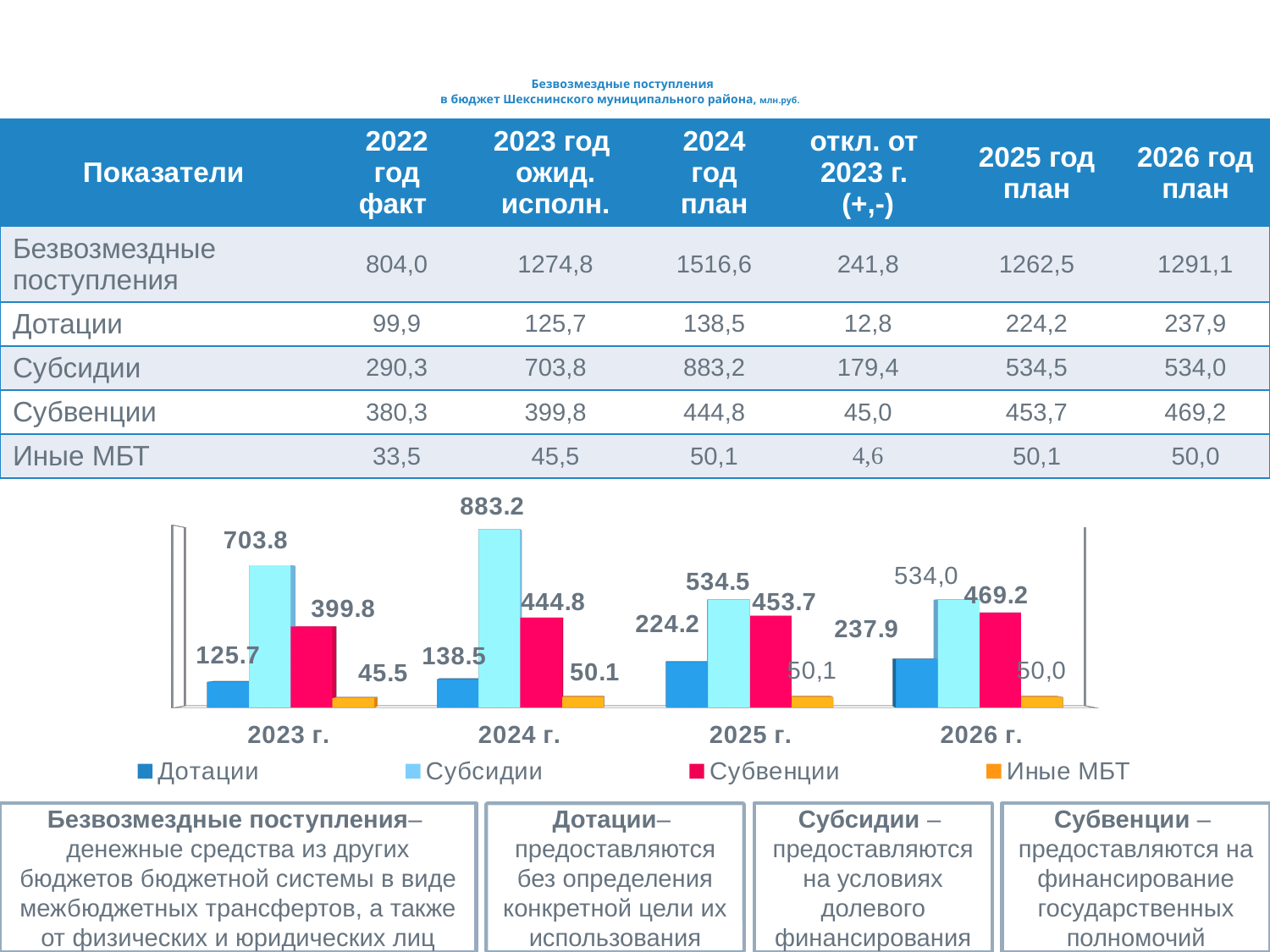
What is the difference between Субсидии and Субвенции in 2023 г. in the chart? 304.0 How many series does the chart legend list? 4 Which is larger in 2025 г. in the chart: Субсидии or Субвенции? Субсидии In which year does Субсидии reach its highest value in the chart? 2024 г. Which series has the lowest value in 2023 г. in the chart? Иные МБТ What is the value of Субвенции for 2026 г. in the chart? 469.2 Do the values for Дотации rise or fall from 2023 г. to 2026 г. in the chart? rise What type of chart is shown on the slide? bar chart What is the value of Субсидии for 2024 г. in the chart? 883.2 How many year categories are shown on the x axis of the chart? 4 What is the value of Иные МБТ for 2025 г. in the chart? 50,1 What is the value of Дотации for 2023 г. in the chart? 125.7